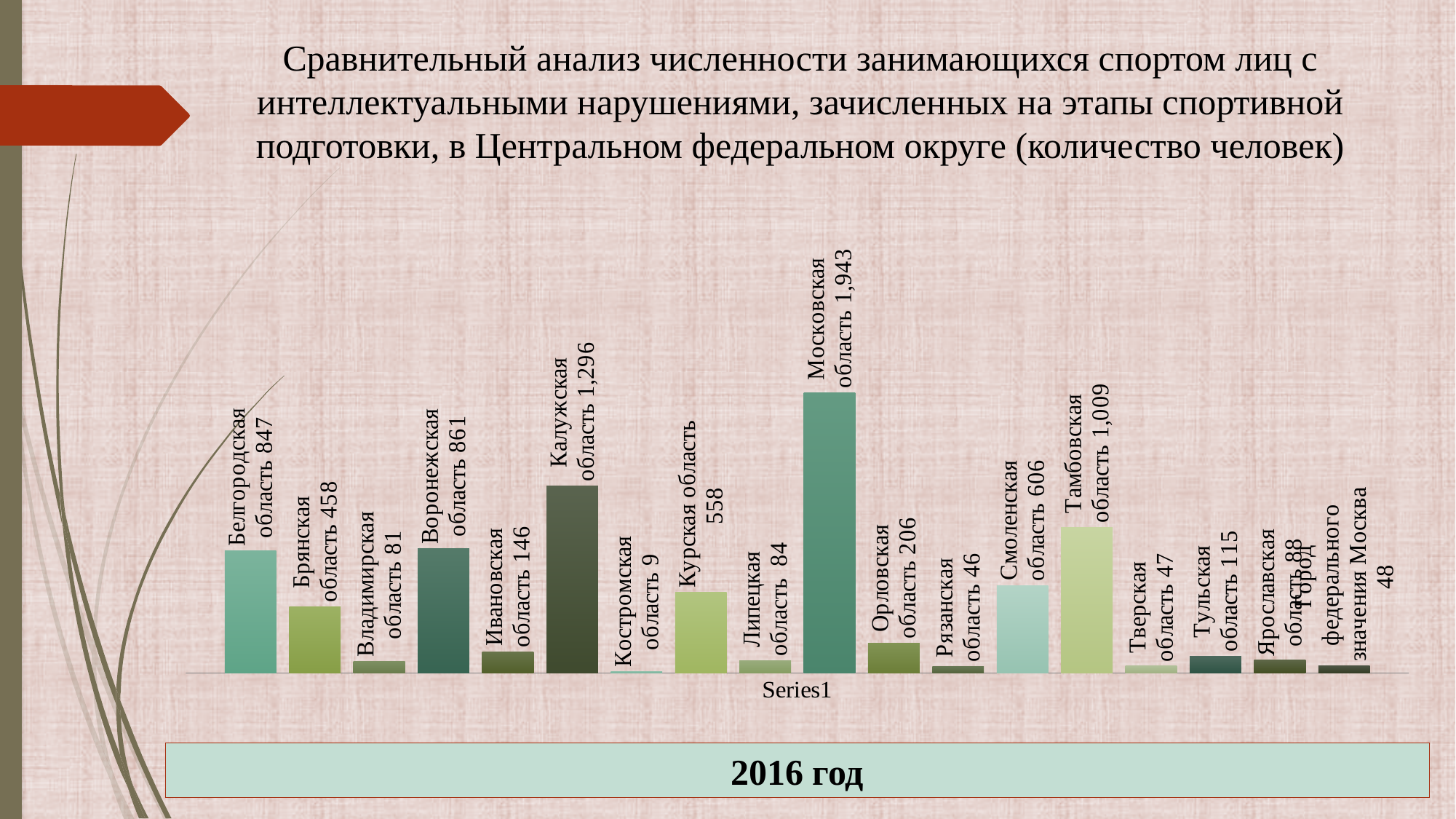
Which region has the lowest value? Костромская область What is the value for Город федерального значения Москва? 48 Which is larger, the value for Тамбовская область or the value for Смоленская область? Тамбовская область What year is indicated in the box below the chart? 2016 год What is the value for Костромская область? 9 What is the value for Калужская область? 1,296 What kind of chart is shown on the slide? Bar chart Which region has the highest value? Московская область What is the difference between the values for Московская область and Калужская область? 647 What is the difference between the values for Воронежская область and Белгородская область? 14 How many regions (bars) are shown in the chart? 18 What is the value for Московская область? 1,943